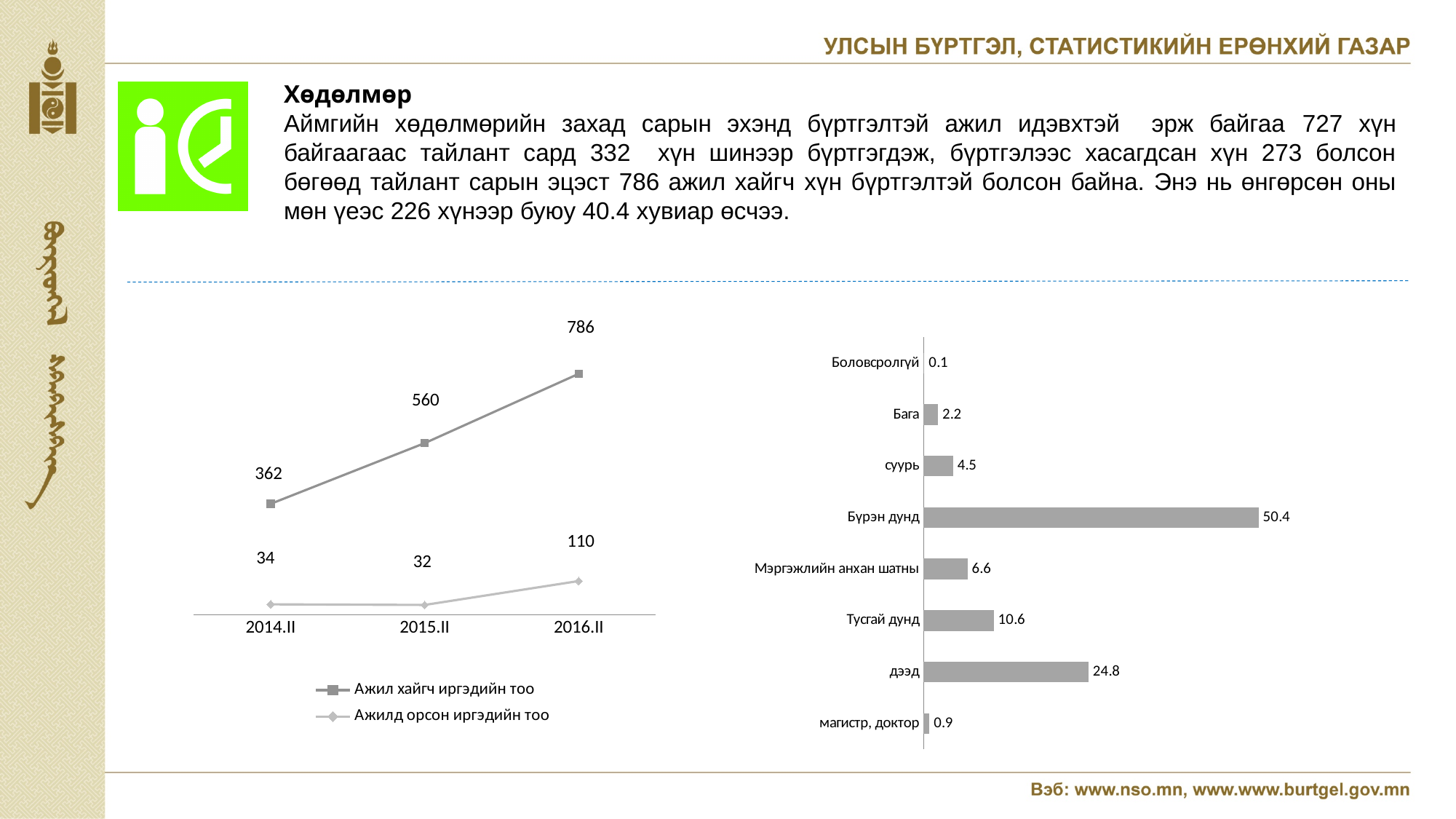
In the bar chart on the right, which category has the lowest value? Боловсролгүй In the line chart on the left, what is the value of Ажил хайгч иргэдийн тоо for 2016.II? 786 In the line chart on the left, how many series does the legend list? 2 In the line chart on the left, what is the value of Ажилд орсон иргэдийн тоо for 2015.II? 32 In the line chart on the left, by how much did Ажил хайгч иргэдийн тоо increase from 2014.II to 2016.II? 424 What kind of chart is the chart on the left? line chart In the bar chart on the right, what is the value for Бүрэн дунд? 50.4 In the bar chart on the right, which category has the highest value? Бүрэн дунд In the bar chart on the right, how many categories are shown? 8 In the line chart on the left, does Ажил хайгч иргэдийн тоо rise or fall from 2014.II to 2016.II? rise In the line chart on the left, how many time periods are shown on the x axis? 3 In the bar chart on the right, what is the difference between дээд and Тусгай дунд? 14.2